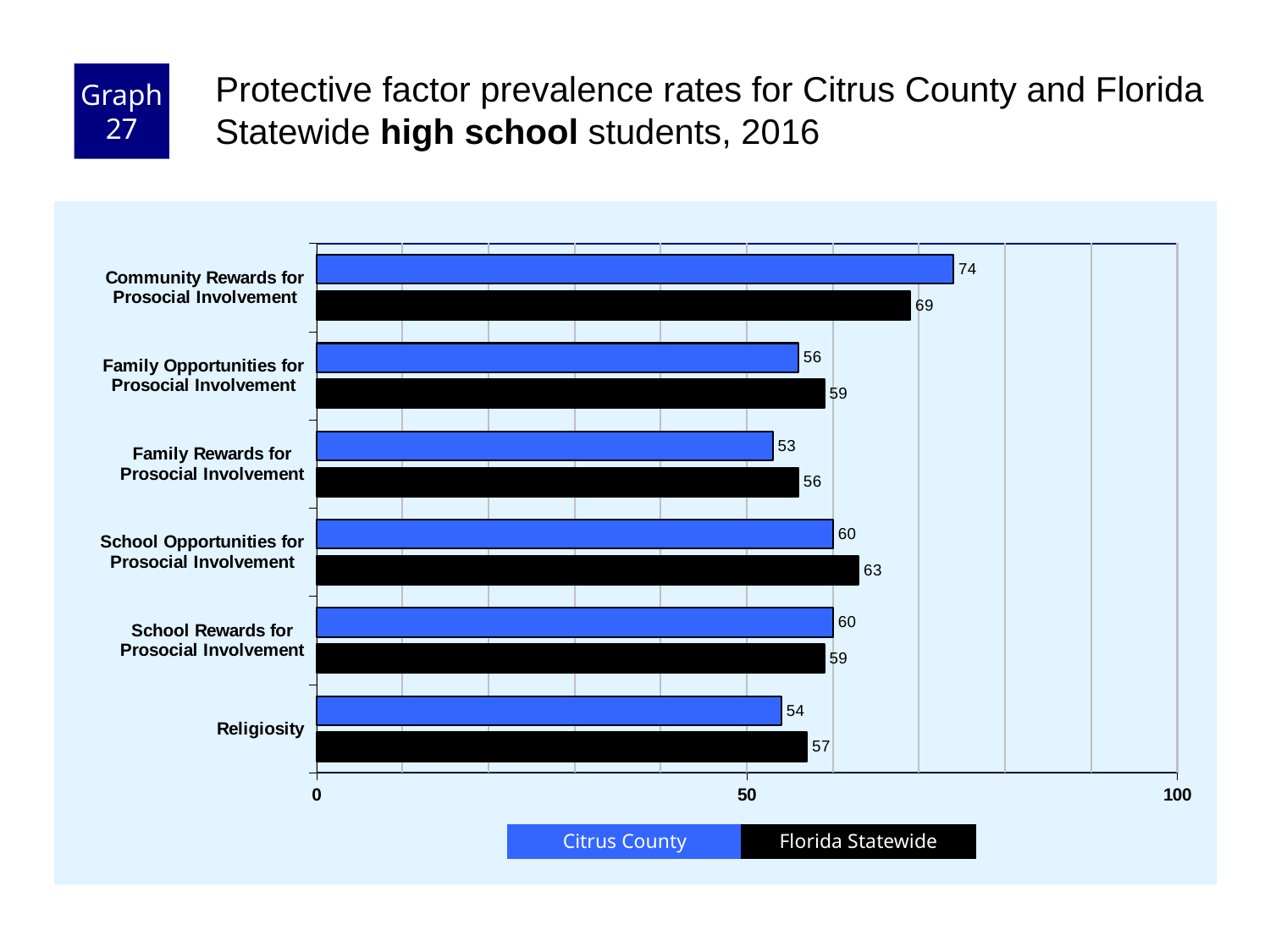
What is the Citrus County value for Community Rewards for Prosocial Involvement? 74 How many categories are shown on the chart? 6 For Family Opportunities for Prosocial Involvement, which is larger: the Citrus County value or the Florida Statewide value? Florida Statewide What is the Florida Statewide value for Religiosity? 57 Is the Citrus County value for Community Rewards for Prosocial Involvement greater or less than 50? greater What is the Florida Statewide value for School Opportunities for Prosocial Involvement? 63 What kind of chart is shown on the slide? bar chart How many series does the legend list? 2 What is the difference between the Citrus County and Florida Statewide values for Community Rewards for Prosocial Involvement? 5 Which category has the lowest Citrus County value? Family Rewards for Prosocial Involvement Which category has the highest Citrus County value? Community Rewards for Prosocial Involvement What is the difference between the Florida Statewide and Citrus County values for Family Rewards for Prosocial Involvement? 3